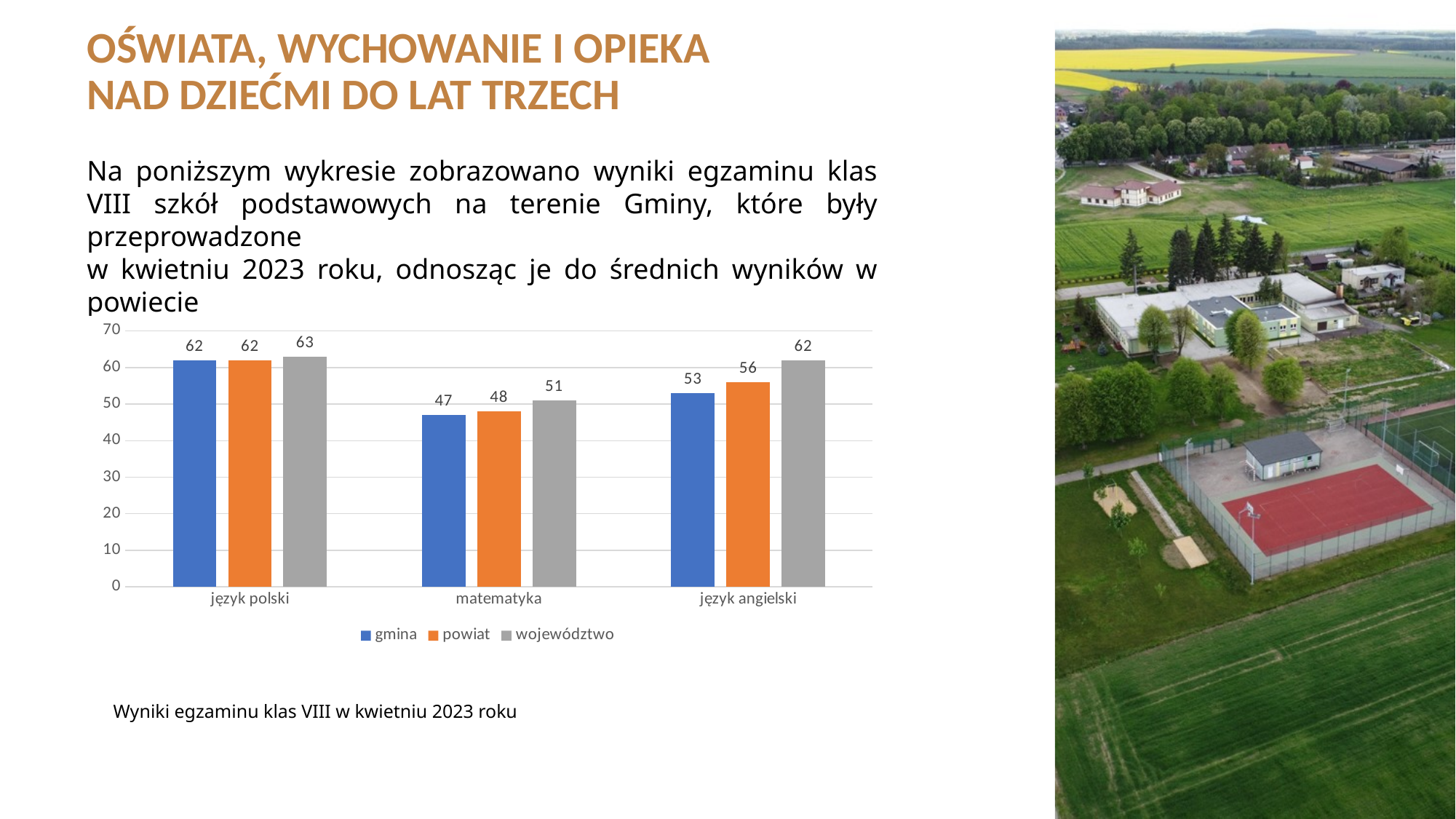
How many series does the legend list? 3 What kind of chart is shown on the slide? bar chart Is the value for gmina in matematyka greater or less than 50? less What is the value for gmina in język polski? 62 What is the value for powiat in język angielski? 56 Which subject has the highest value for województwo? język polski What is the value for województwo in matematyka? 51 What is the difference between the województwo and gmina values in język angielski? 9 Which is larger in język angielski: the value for gmina or the value for powiat? powiat How many subject categories are shown on the x axis? 3 Which subject has the lowest value for gmina? matematyka What is the difference between the powiat and gmina values in matematyka? 1